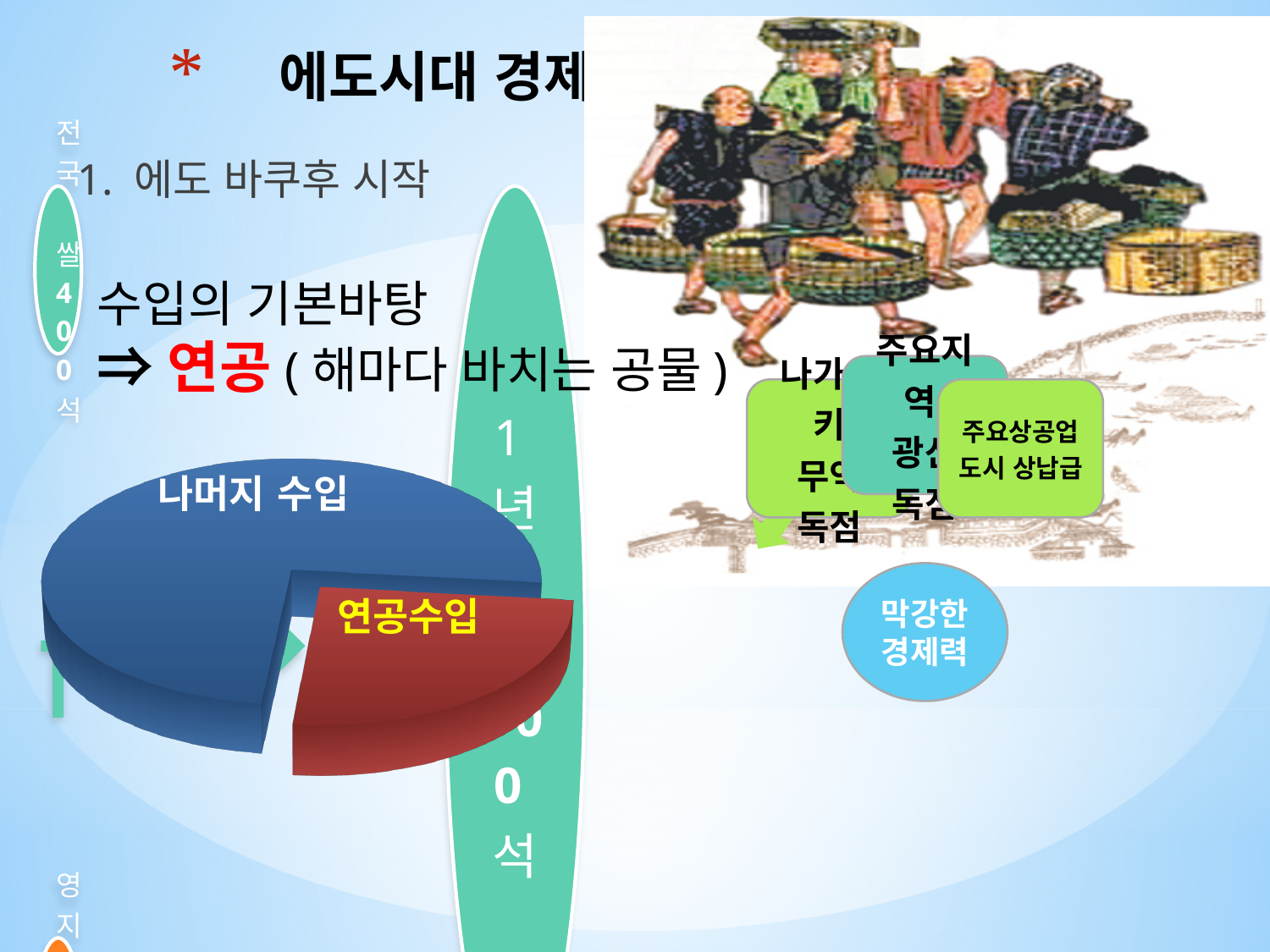
Which slice of the pie chart is the largest? 나머지 수입 Which is larger in the pie chart, 나머지 수입 or 연공수입? 나머지 수입 What colour is the 나머지 수입 slice of the pie chart? blue What colour is the 연공수입 slice of the pie chart? red How many slices does the pie chart have? 2 Which slice of the pie chart is the smallest? 연공수입 What kind of chart is shown on the slide? pie chart